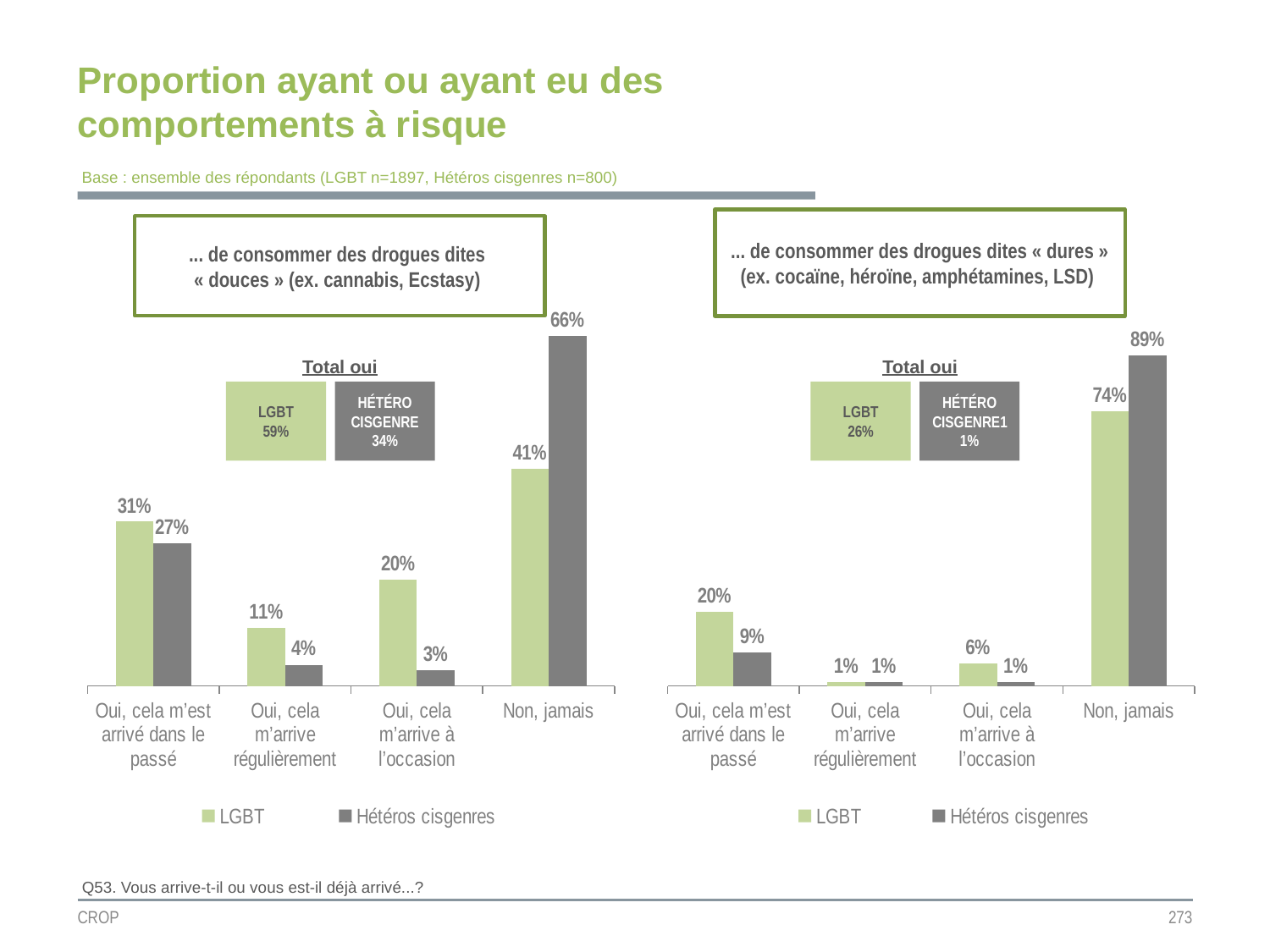
In the left chart on soft drugs (« douces »), what is the Hétéros cisgenres value for "Oui, cela m'arrive régulièrement"? 4% How many categories are shown on the x axis of the right chart on hard drugs (« dures »)? 4 In the left chart on soft drugs (« douces »), which category has the highest Hétéros cisgenres value? Non, jamais How many series does the legend of the left chart on soft drugs (« douces ») list? 2 In the left chart on soft drugs (« douces »), what is the LGBT value for "Non, jamais"? 41% What type of chart is used for the soft drugs (« douces ») data on the left? Bar chart In the right chart on hard drugs (« dures »), what is the difference between the LGBT and Hétéros cisgenres values for "Oui, cela m'arrive à l'occasion"? 5% In the right chart on hard drugs (« dures »), what is the LGBT value for "Oui, cela m'est arrivé dans le passé"? 20% In the left chart on soft drugs (« douces »), what is the difference between the Hétéros cisgenres and LGBT values for "Non, jamais"? 25% In the right chart on hard drugs (« dures »), which category has the lowest LGBT value? Oui, cela m'arrive régulièrement In the left chart on soft drugs (« douces »), which is larger for "Oui, cela m'arrive à l'occasion": the LGBT value or the Hétéros cisgenres value? LGBT In the right chart on hard drugs (« dures »), what is the Hétéros cisgenres value for "Non, jamais"? 89%